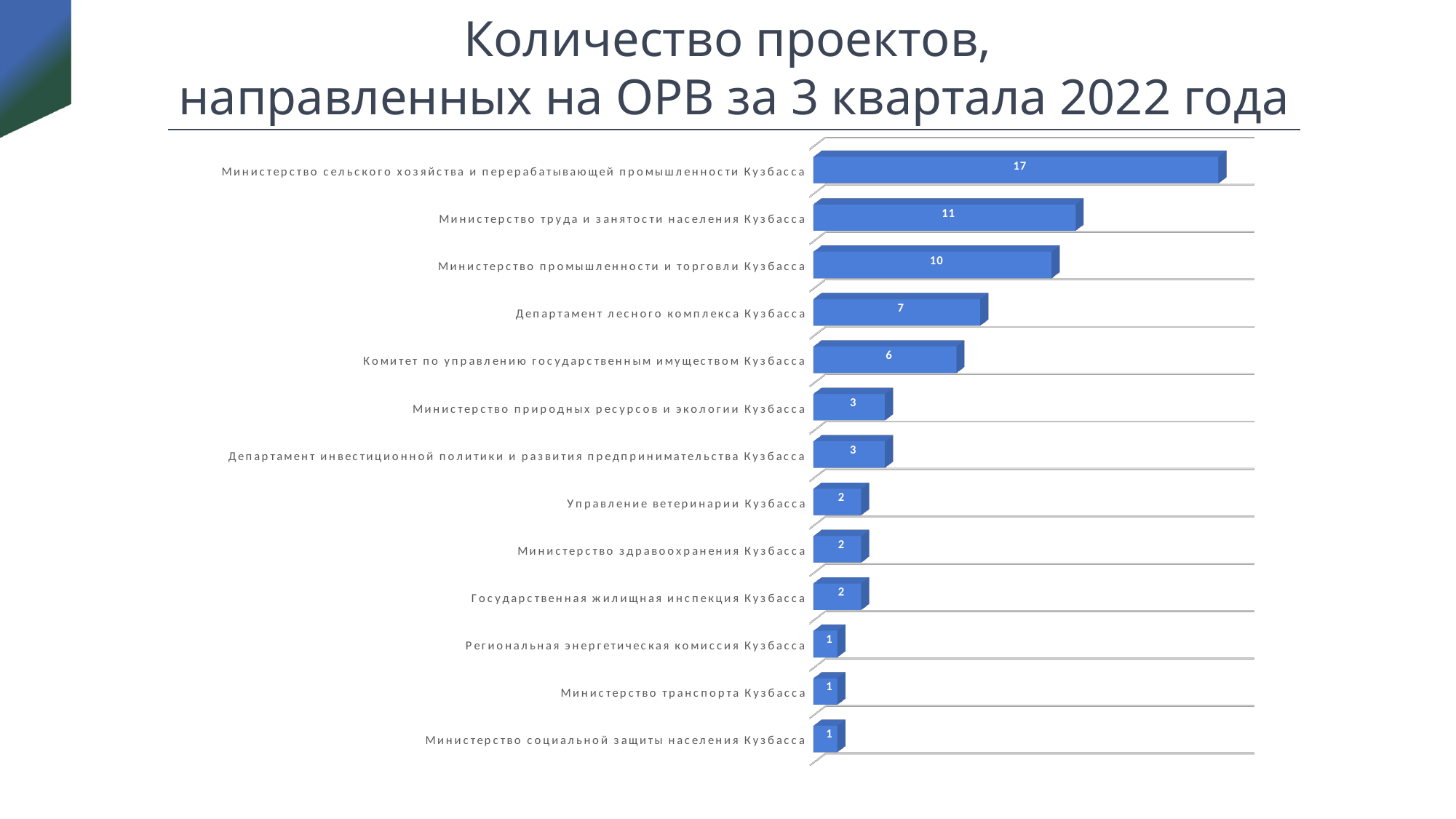
What type of chart is shown on the slide? Bar chart What is the value for Департамент лесного комплекса Кузбасса? 7 What is the value for Министерство здравоохранения Кузбасса? 2 Which is larger: the value for Министерство промышленности и торговли Кузбасса or the value for Комитет по управлению государственным имуществом Кузбасса? Министерство промышленности и торговли Кузбасса How many projects were sent for ОРВ by Министерство сельского хозяйства и перерабатывающей промышленности Кузбасса? 17 What is the difference between the values for Министерство сельского хозяйства и перерабатывающей промышленности Кузбасса and Департамент лесного комплекса Кузбасса? 10 Which category has the highest value? Министерство сельского хозяйства и перерабатывающей промышленности Кузбасса How many categories are shown in the chart? 13 What is the value for Министерство труда и занятости населения Кузбасса? 11 What is the title of the slide? Количество проектов, направленных на ОРВ за 3 квартала 2022 года What is the value for Комитет по управлению государственным имуществом Кузбасса? 6 What is the difference between the values for Министерство труда и занятости населения Кузбасса and Министерство промышленности и торговли Кузбасса? 1